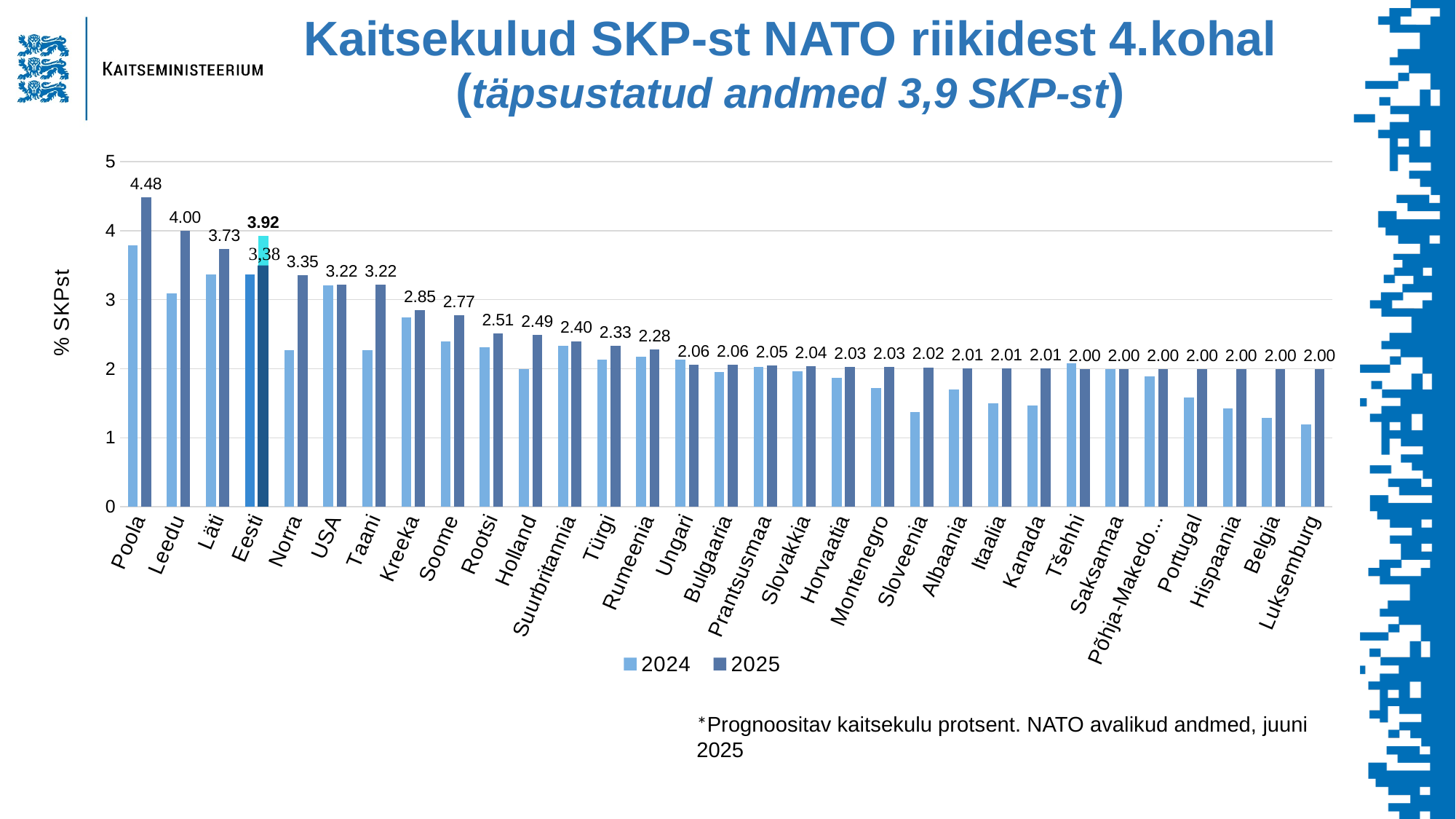
Is the 2024 value for Poola greater or less than 3? greater Do the 2025 values rise or fall from left to right along the x axis? fall What is the 2025 value for Eesti? 3.92 What is the 2025 value for Kreeka? 2.85 How many series does the legend list? 2 What is the 2025 value for Poola? 4.48 What is the 2025 value for Suurbritannia? 2.40 Which country has the highest 2025 value? Poola Is the 2024 value for Luksemburg greater or less than 2? less What is the difference between the 2025 values for Poola and Leedu? 0.48 Which is larger, the 2025 value for Norra or the 2025 value for Kreeka? Norra How many countries are shown on the x axis? 31